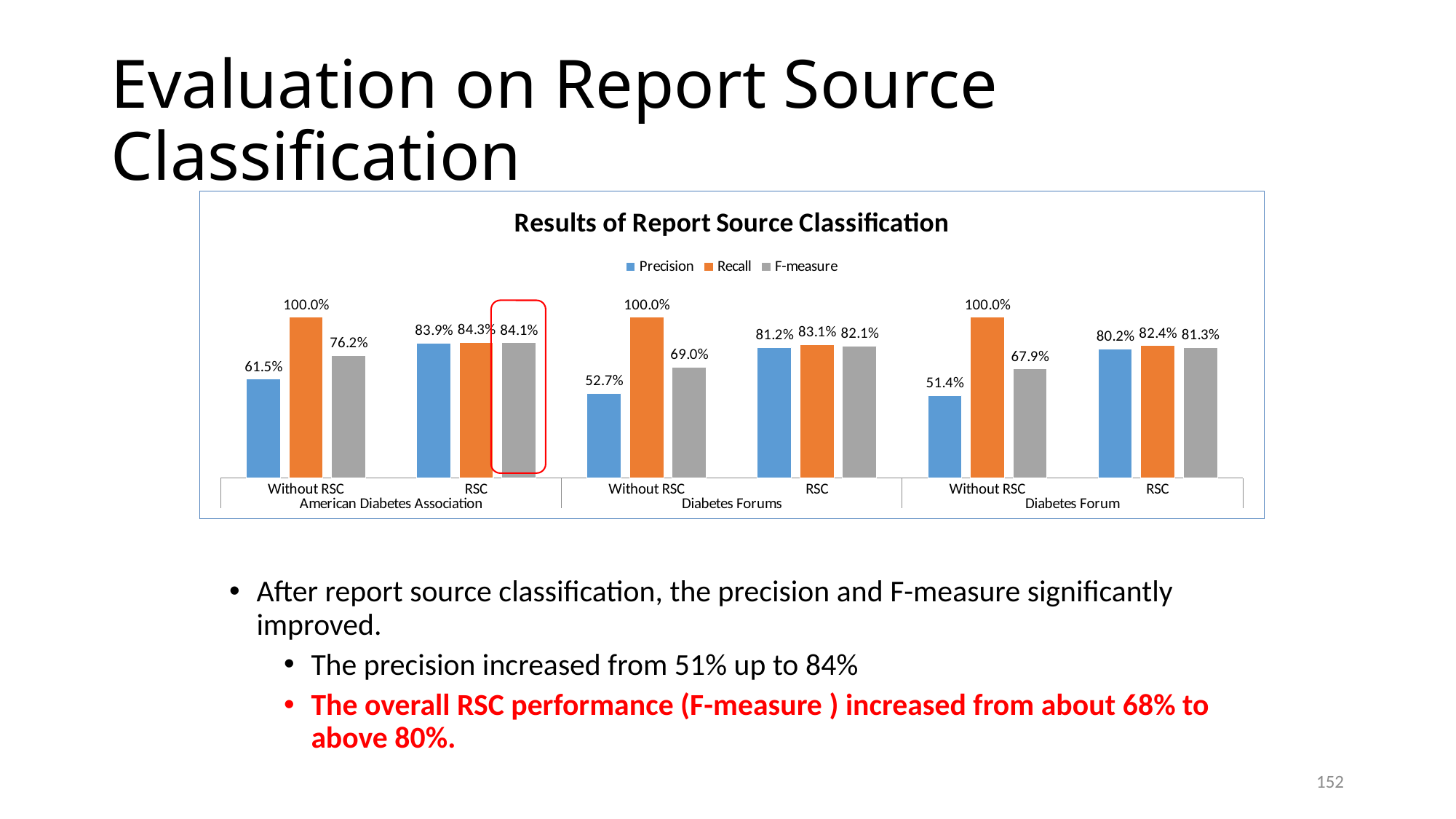
What is the Precision value for RSC under Diabetes Forum? 80.2% What is the difference between the F-measure for RSC and Without RSC under American Diabetes Association? 7.9% What kind of chart is shown on the slide? Bar chart What is the difference between the Precision for RSC and Without RSC under Diabetes Forums? 28.5% Which category group has the lowest Precision value? Without RSC (Diabetes Forum) What is the Recall value for Without RSC under Diabetes Forums? 100.0% What is the F-measure value for Without RSC under Diabetes Forum? 67.9% How many series does the legend list? 3 Which is larger: the Recall for RSC under Diabetes Forums or the Recall for RSC under Diabetes Forum? RSC under Diabetes Forums What is the Precision value for Without RSC under American Diabetes Association? 61.5% What is the title of the chart? Results of Report Source Classification What is the F-measure value for RSC under American Diabetes Association? 84.1%